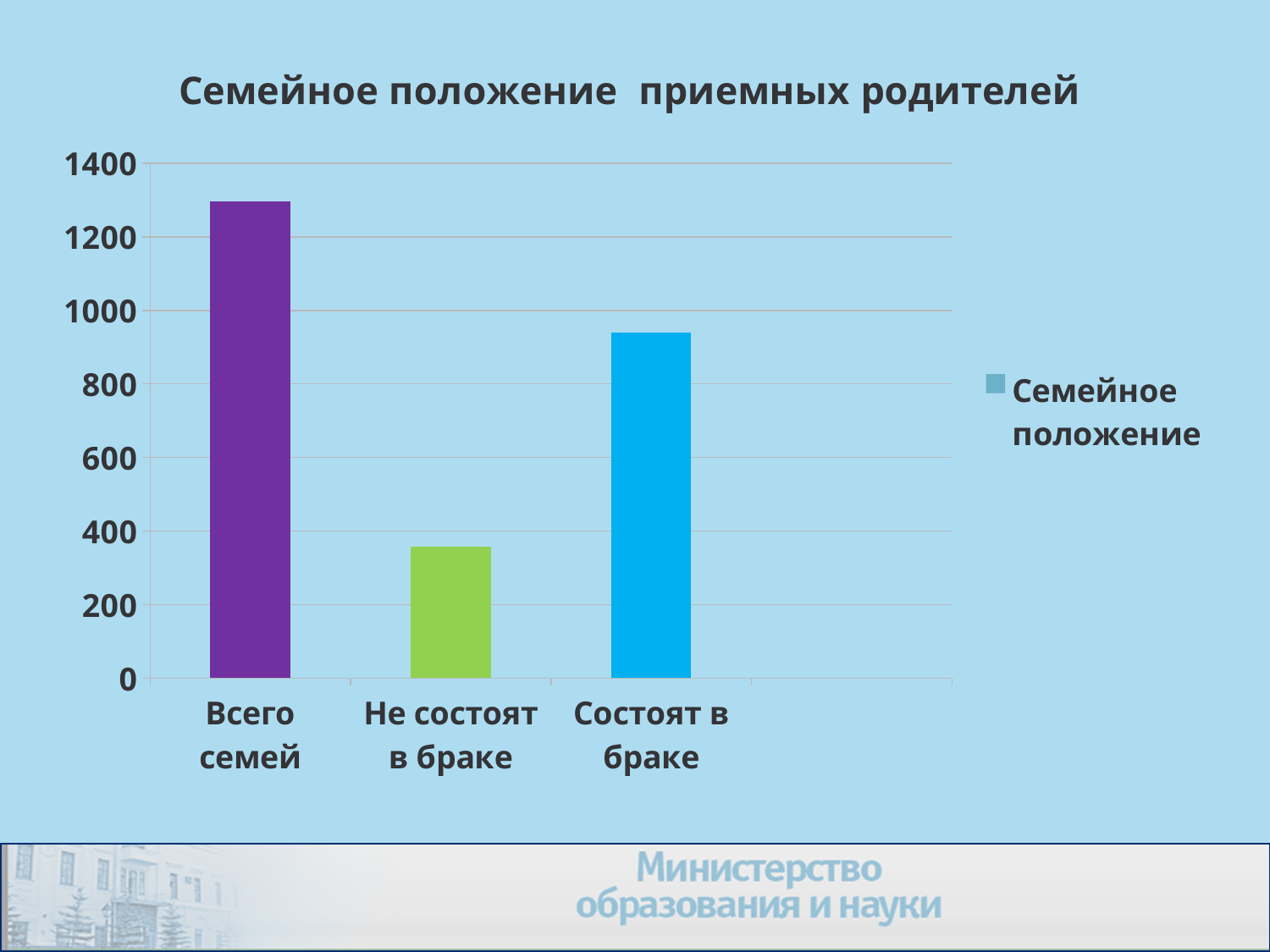
What kind of chart is shown on the slide? bar chart Which category has the lowest bar? Не состоят в браке Which is larger, the value for Состоят в браке or the value for Не состоят в браке? Состоят в браке How many series does the legend list? 1 How many categories are shown on the x axis of the chart? 3 Which category has the highest bar? Всего семей What is the title of the chart? Семейное положение приемных родителей Is the value for Состоят в браке greater or less than 800? greater Is the value for Всего семей greater or less than 1200? greater Is the value for Состоят в браке greater or less than 1000? less What is the legend entry shown on the chart? Семейное положение